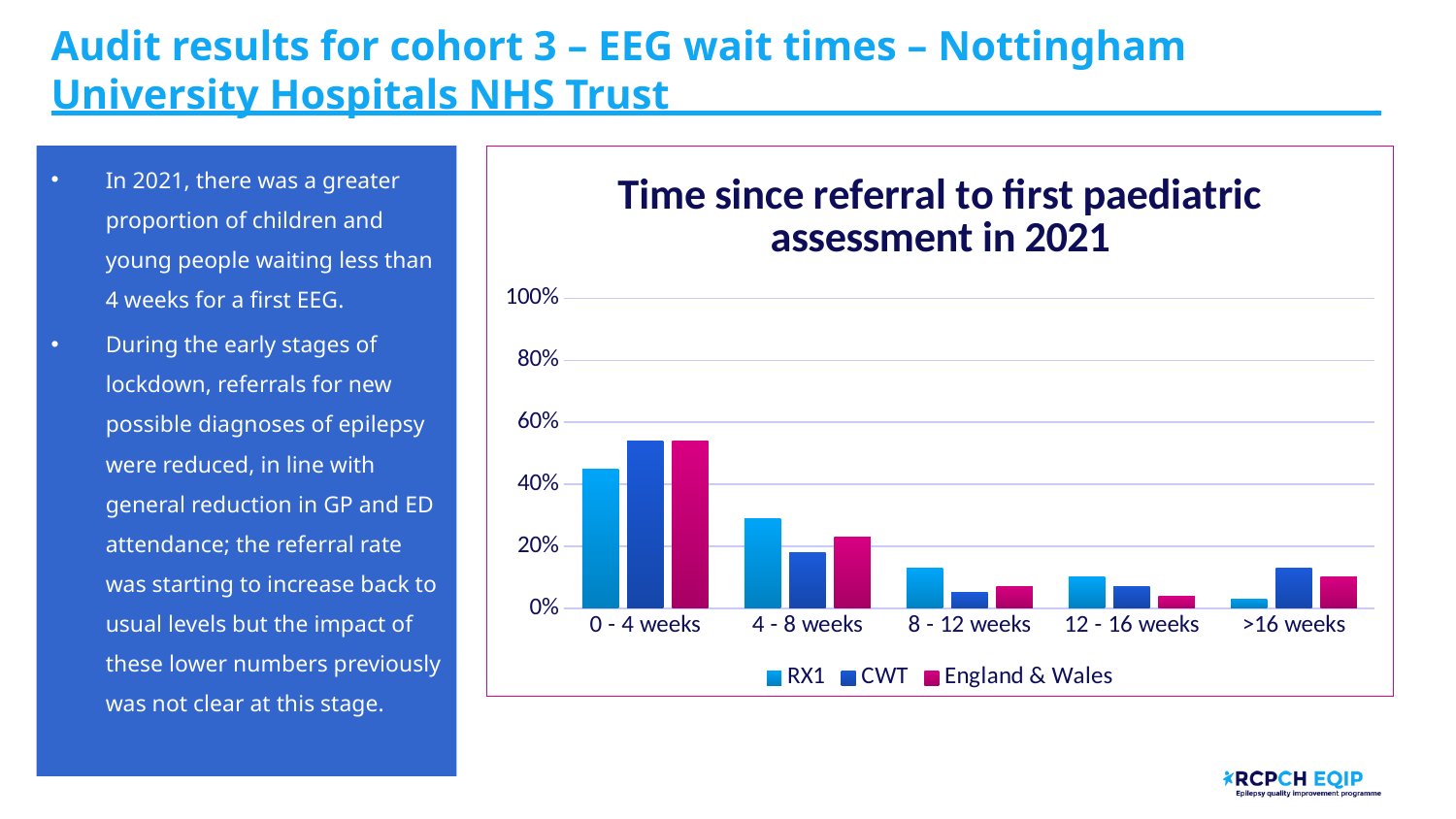
Is the CWT value for 0 - 4 weeks greater or less than 60%? less What is the title of the chart? Time since referral to first paediatric assessment in 2021 How many series does the legend list? 3 Is the RX1 value for 4 - 8 weeks greater or less than 20%? greater For >16 weeks, which is larger: RX1 or CWT? CWT For the RX1 series, which wait-time category has the highest value? 0 - 4 weeks For the RX1 series, which wait-time category has the lowest value? >16 weeks For 4 - 8 weeks, which is larger: RX1 or CWT? RX1 Is the RX1 value for 0 - 4 weeks greater or less than 40%? greater What kind of chart is shown on the slide? Bar chart Do the RX1 values rise or fall as you move from 0 - 4 weeks to >16 weeks? fall How many wait-time categories are shown on the x axis? 5